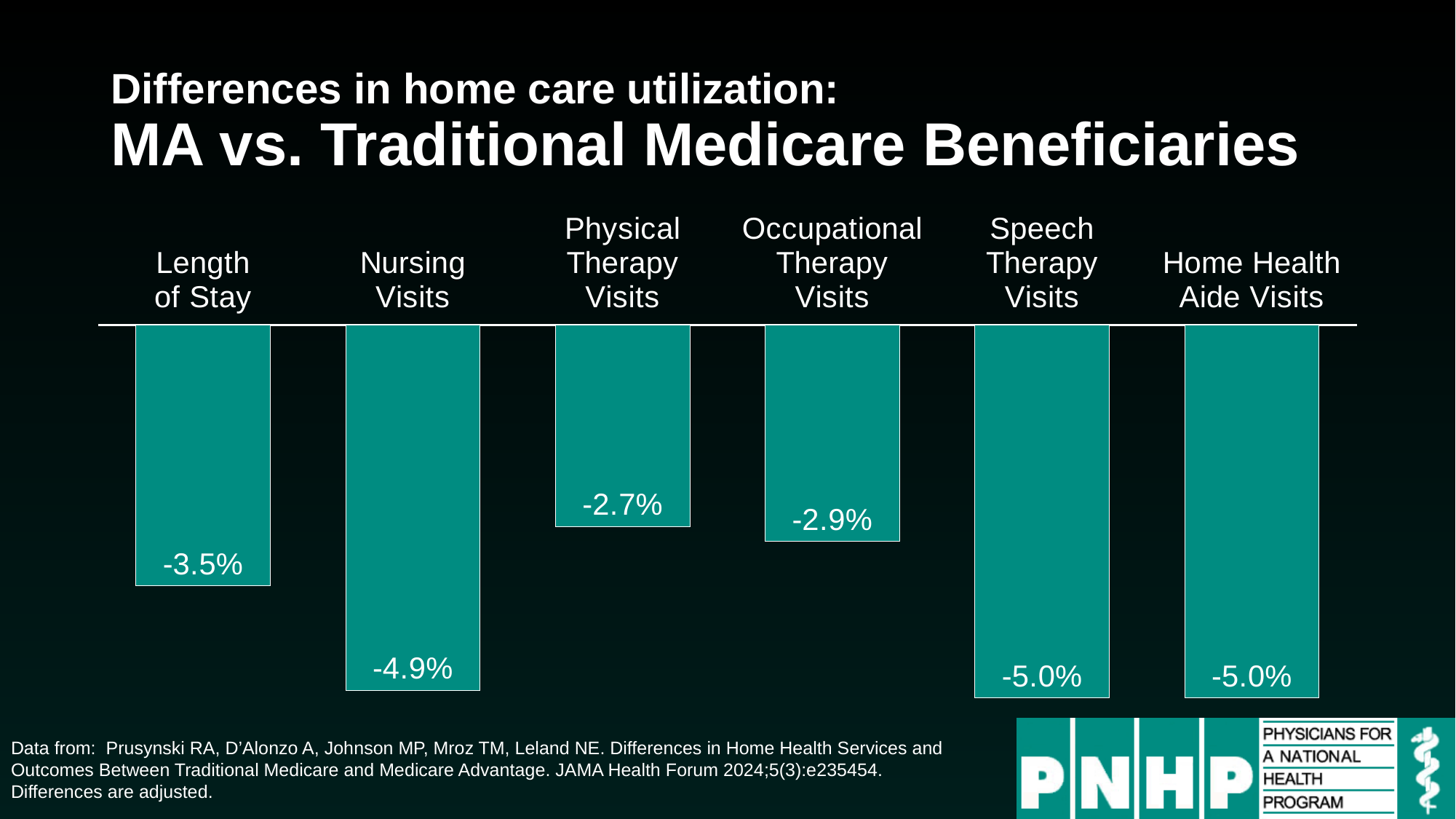
What kind of chart is shown on the slide? Bar chart What is the value for Speech Therapy Visits? -5.0% Which shows a larger decrease, Nursing Visits or Length of Stay? Nursing Visits Which category has the smallest decrease (the value closest to zero)? Physical Therapy Visits What is the value for Home Health Aide Visits? -5.0% What is the value for Nursing Visits? -4.9% What is the value for Physical Therapy Visits? -2.7% What is the value for Length of Stay? -3.5% What is the value for Occupational Therapy Visits? -2.9% What is the difference between the values for Nursing Visits and Length of Stay? 1.4 percentage points What colour are the bars in the chart? Teal How many categories are shown in the chart? 6